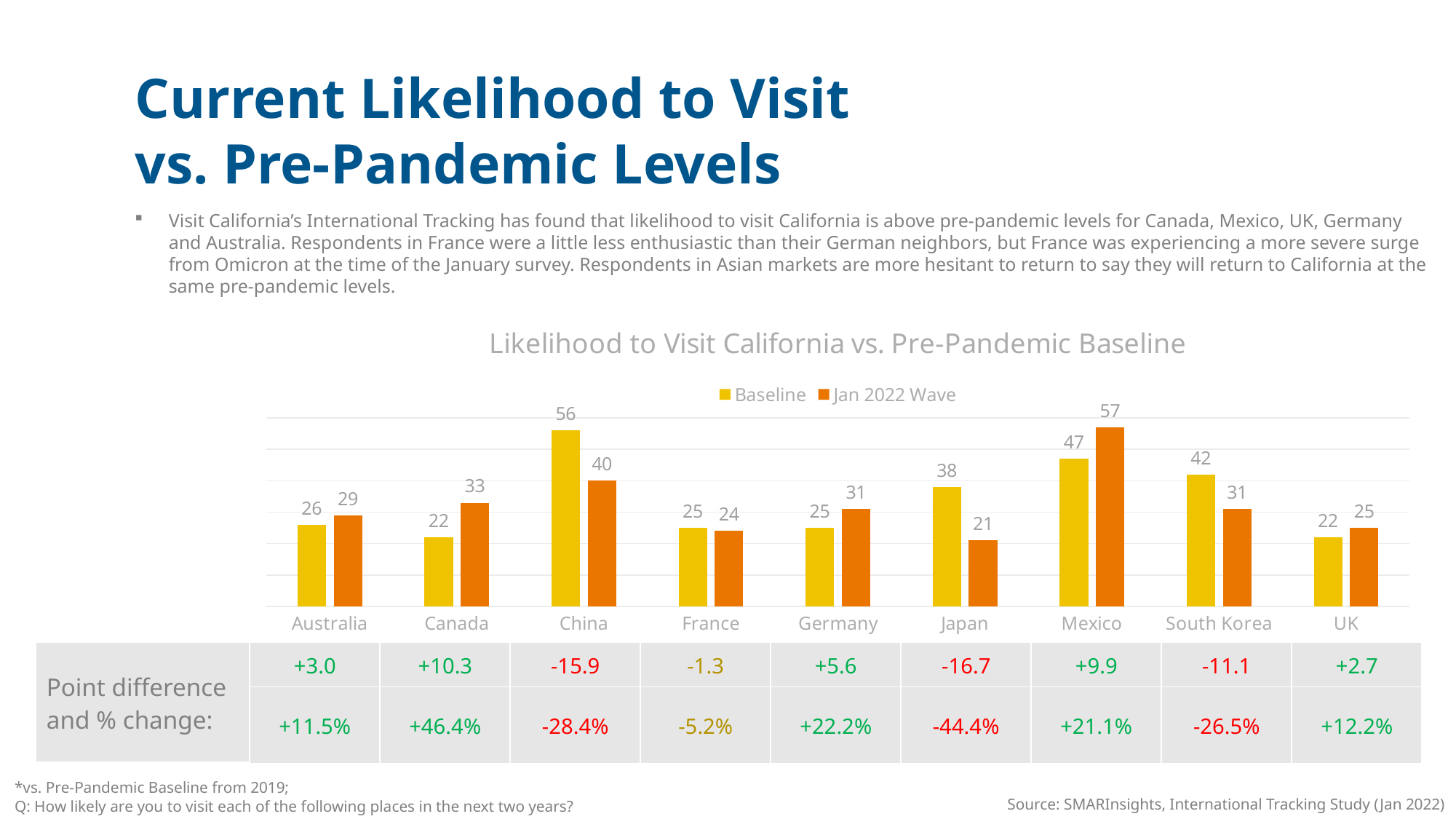
Which country has the highest Jan 2022 Wave value? Mexico What is the Jan 2022 Wave value for Mexico? 57 What kind of chart is shown on the slide? Bar chart How many countries are shown on the x axis of the chart? 9 What is the Baseline value for China? 56 What is the difference between the Baseline and Jan 2022 Wave values for China? 16 Which country has the highest Baseline value? China What is the title of the chart? Likelihood to Visit California vs. Pre-Pandemic Baseline What is the Jan 2022 Wave value for Japan? 21 Which is larger for South Korea, the Baseline value or the Jan 2022 Wave value? Baseline Which country has the lowest Jan 2022 Wave value? Japan How many series does the chart legend list? 2